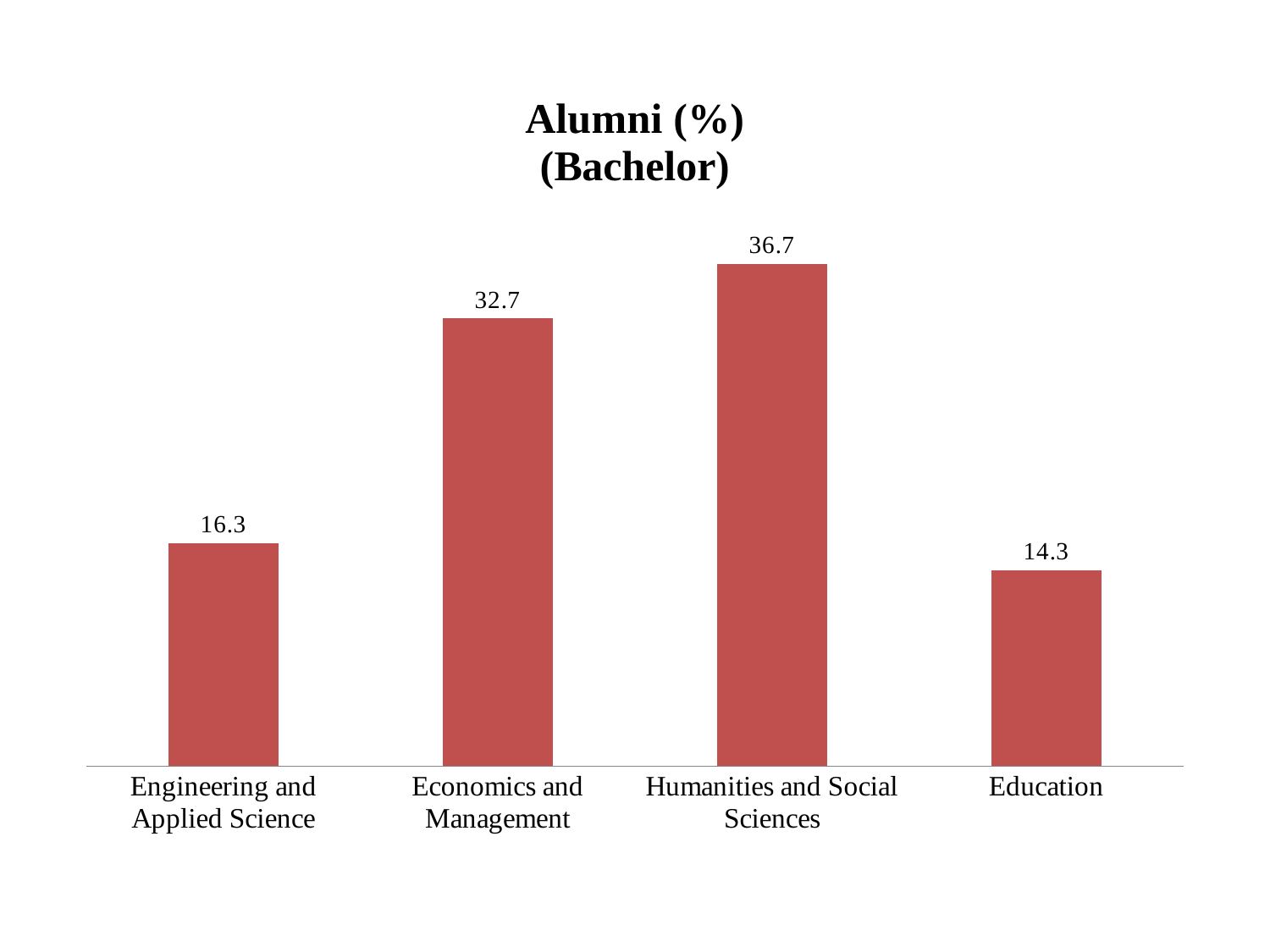
Which category has the highest value? Humanities and Social Sciences How many categories are shown in the chart? 4 What kind of chart is shown on the slide? bar chart What is the difference between the values for Humanities and Social Sciences and Economics and Management? 4.0 What is the difference between the values for Engineering and Applied Science and Education? 2.0 What is the value for Education? 14.3 What is the title of the chart? Alumni (%) (Bachelor) Which is larger, the value for Economics and Management or the value for Engineering and Applied Science? Economics and Management What is the value for Engineering and Applied Science? 16.3 What is the value for Humanities and Social Sciences? 36.7 Which category has the lowest value? Education What is the value for Economics and Management? 32.7